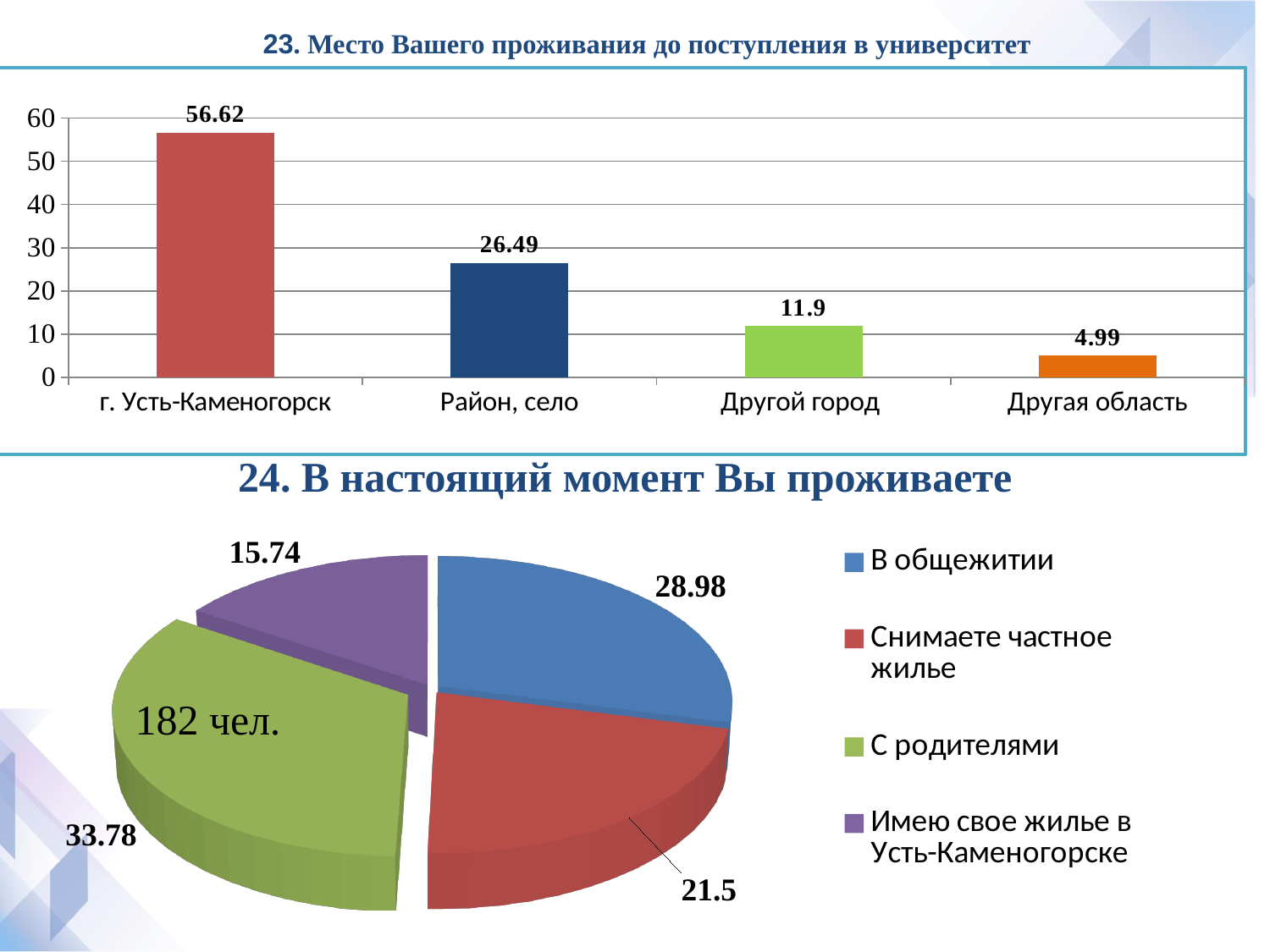
In the pie chart titled "24. В настоящий момент Вы проживаете", which is larger: "В общежитии" or "Снимаете частное жилье"? В общежитии In the bar chart titled "23. Место Вашего проживания до поступления в университет", what is the value for "г. Усть-Каменогорск"? 56.62 In the pie chart titled "24. В настоящий момент Вы проживаете", what is the value for "Имею свое жилье в Усть-Каменогорске"? 15.74 In the bar chart titled "23. Место Вашего проживания до поступления в университет", which category has the lowest value? Другая область In the pie chart titled "24. В настоящий момент Вы проживаете", how many entries does the legend list? 4 In the bar chart titled "23. Место Вашего проживания до поступления в университет", what is the value for "Другой город"? 11.9 In the bar chart titled "23. Место Вашего проживания до поступления в университет", how many categories are shown? 4 In the bar chart titled "23. Место Вашего проживания до поступления в университет", what is the difference between the values for "г. Усть-Каменогорск" and "Район, село"? 30.13 In the pie chart titled "24. В настоящий момент Вы проживаете", what is the value for "С родителями"? 33.78 In the pie chart titled "24. В настоящий момент Вы проживаете", which category has the largest slice? С родителями In the bar chart titled "23. Место Вашего проживания до поступления в университет", do the values rise or fall from left to right? fall What kind of chart is the top chart on the slide? bar chart